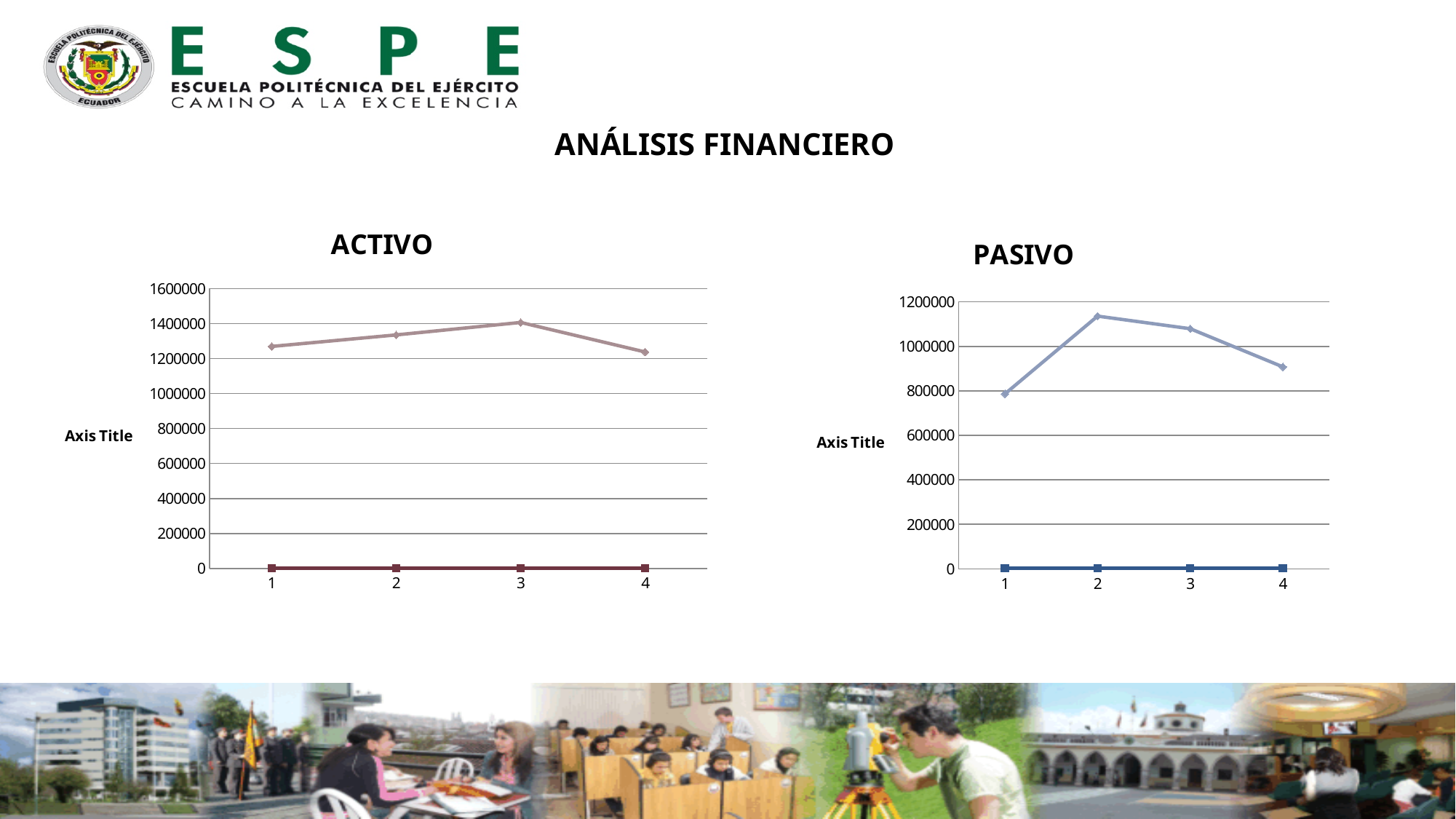
In the PASIVO chart, at which x-axis category does the upper line reach its highest value? 2 In the ACTIVO chart, is the value of the upper line at category 1 greater or less than 1200000? greater In the ACTIVO chart, is the value of the upper line at category 4 greater or less than 1400000? less What kind of chart is the ACTIVO chart? line chart In the PASIVO chart, is the value of the upper line at category 2 greater or less than 1000000? greater In the ACTIVO chart, at which x-axis category does the upper line reach its highest value? 3 In the PASIVO chart, does the upper line rise or fall from category 2 to category 4? fall In the PASIVO chart, at which x-axis category does the upper line reach its lowest value? 1 How many points are plotted along the x axis of the PASIVO chart? 4 In the PASIVO chart, which is larger for the upper line: the value at category 2 or at category 4? category 2 What is the highest tick label on the y axis of the ACTIVO chart? 1600000